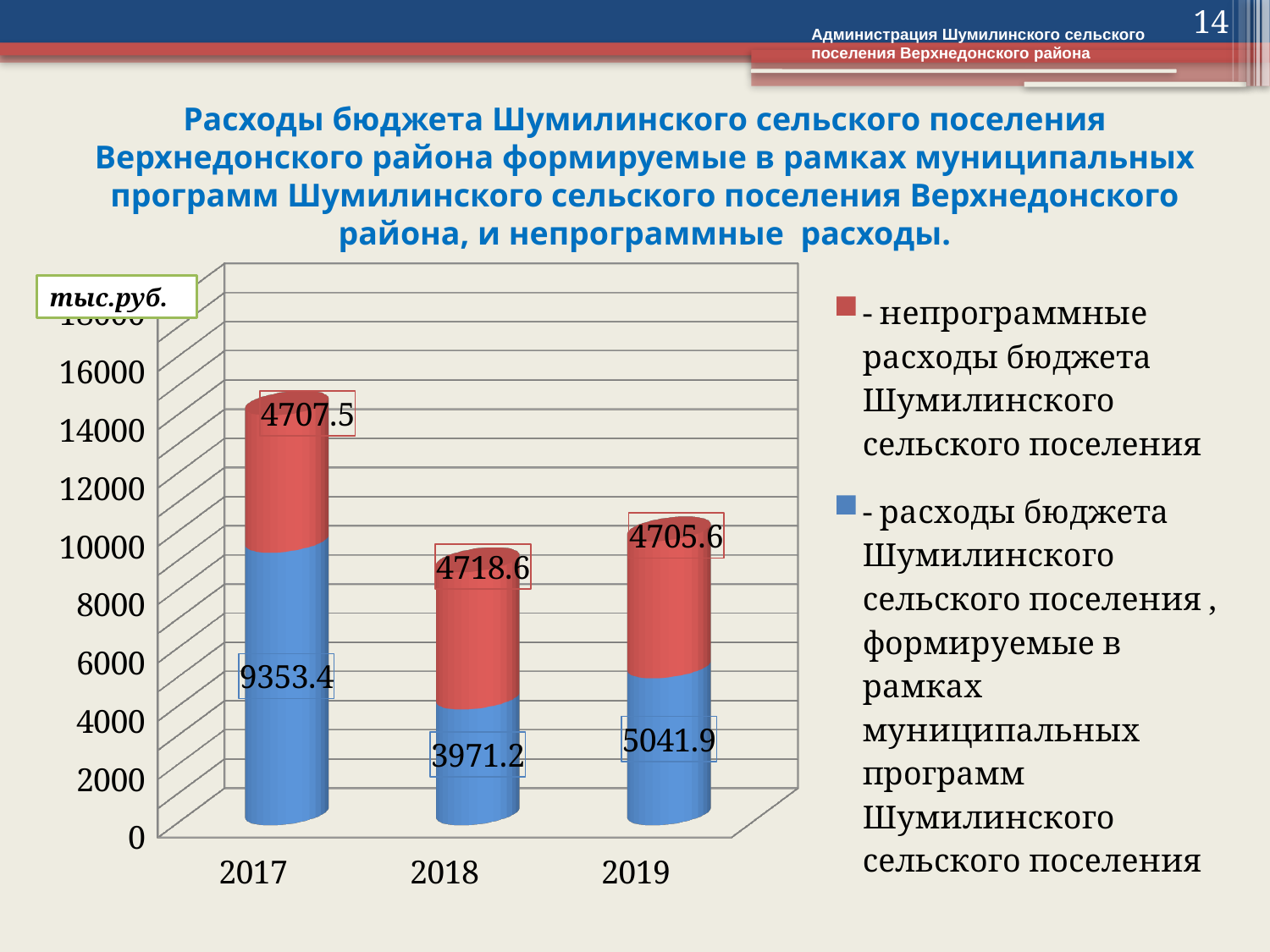
What is the value of the red series (непрограммные расходы) for 2019? 4705.6 What is the total of the stacked bar for 2017? 14060.9 In which year is the blue series (расходы в рамках муниципальных программ) highest? 2017 How many years (categories) are shown on the x axis? 3 What is the value of the red series (непрограммные расходы бюджета) for 2018? 4718.6 What is the difference between the blue series values for 2017 and 2018? 5382.2 What is the value of the blue series (расходы в рамках муниципальных программ) for 2019? 5041.9 What is the value of the blue series (расходы бюджета, формируемые в рамках муниципальных программ) for 2017? 9353.4 What is the total of the stacked bar for 2018? 8689.8 Which is larger: the blue series value for 2019 or the red series value for 2019? 5041.9 (blue series, 2019) In which year is the blue series (расходы в рамках муниципальных программ) lowest? 2018 How many series does the legend list? 2